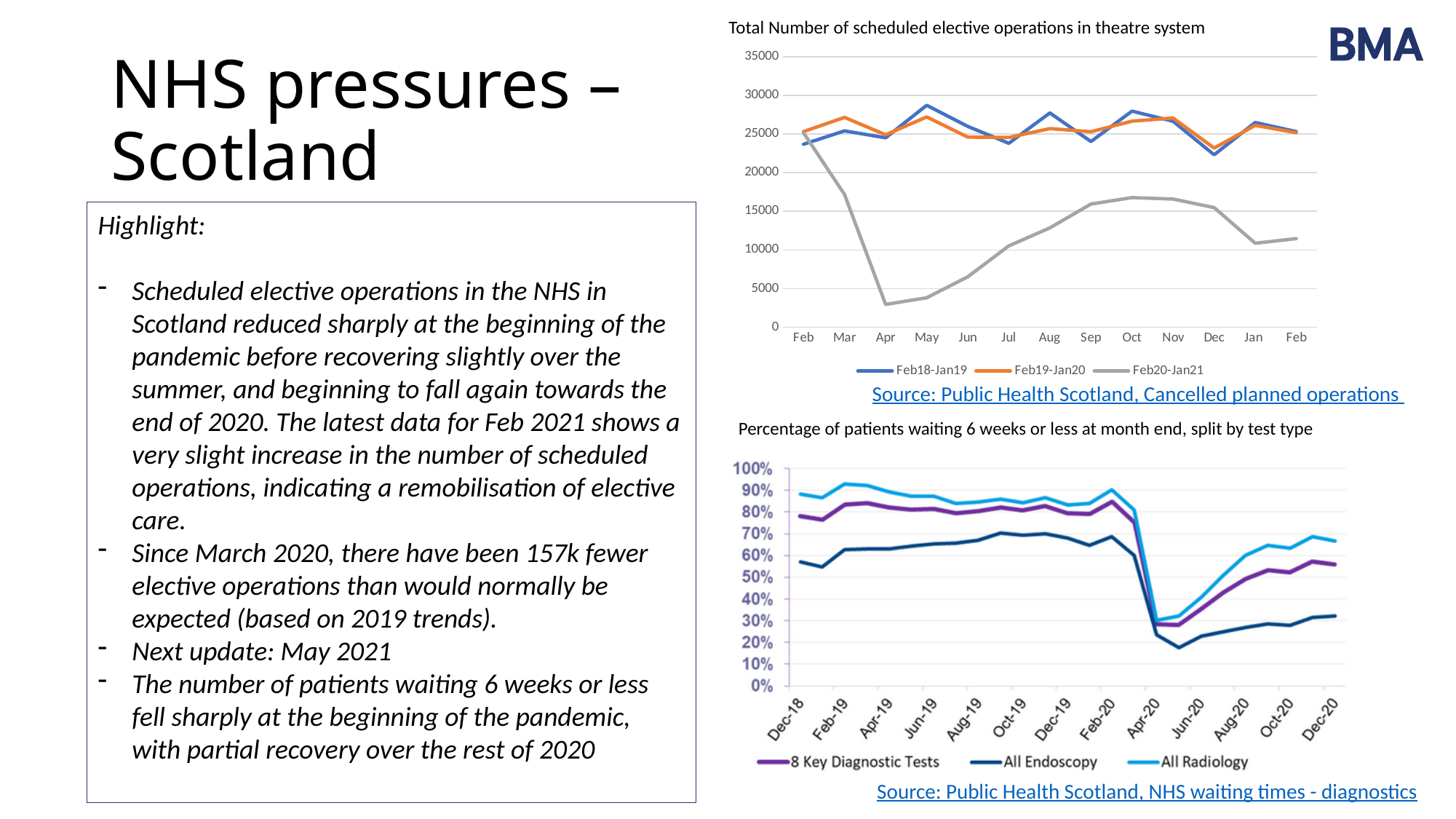
In the top chart (scheduled elective operations), is the Feb20-Jan21 value for Apr greater or less than 5000? less In the top chart (scheduled elective operations), is the Feb20-Jan21 value for Oct greater or less than 15000? greater In the bottom chart (percentage of patients waiting 6 weeks or less), is the All Endoscopy value for Apr-20 greater or less than 30%? less In the bottom chart (percentage of patients waiting 6 weeks or less), which series has the larger value in Dec-20: All Radiology or All Endoscopy? All Radiology How many series does the legend of the top chart (scheduled elective operations) list? 3 How many series does the legend of the bottom chart (percentage of patients waiting 6 weeks or less) list? 3 In the top chart (scheduled elective operations), which series has the larger value in Apr: Feb18-Jan19 or Feb20-Jan21? Feb18-Jan19 In the top chart (scheduled elective operations), which month has the lowest value for the Feb20-Jan21 series? Apr What type of chart is the top chart, 'Total Number of scheduled elective operations in theatre system'? line chart In the top chart (scheduled elective operations), does the Feb20-Jan21 series rise or fall from Feb to Apr? fall